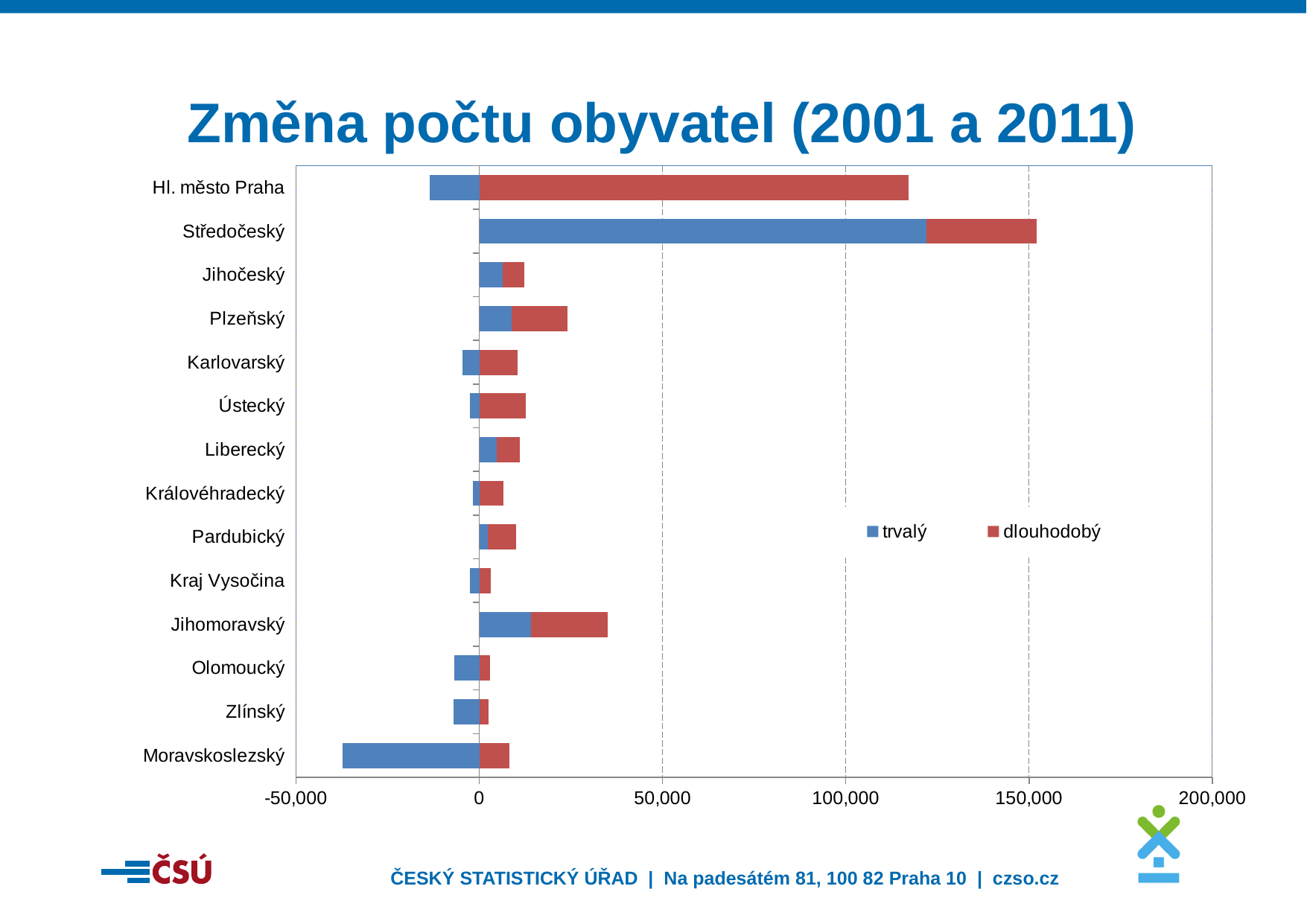
Which region has the lowest (most negative) trvalý value? Moravskoslezský Which region has the highest dlouhodobý value? Hl. město Praha What kind of chart is shown on the slide? Stacked horizontal bar chart Is the trvalý value for Moravskoslezský greater or less than 0? less How many regions (categories) are listed on the vertical axis of the chart? 14 How many series does the chart legend list? 2 Is the dlouhodobý value for Hl. město Praha greater or less than 100,000? greater Is the trvalý value for Středočeský greater or less than 100,000? greater Which series is shown in red in the chart? dlouhodobý What is the title of the chart on the slide? Změna počtu obyvatel (2001 a 2011) Which region has the highest trvalý value? Středočeský Which is larger, the trvalý value for Středočeský or the trvalý value for Hl. město Praha? Středočeský